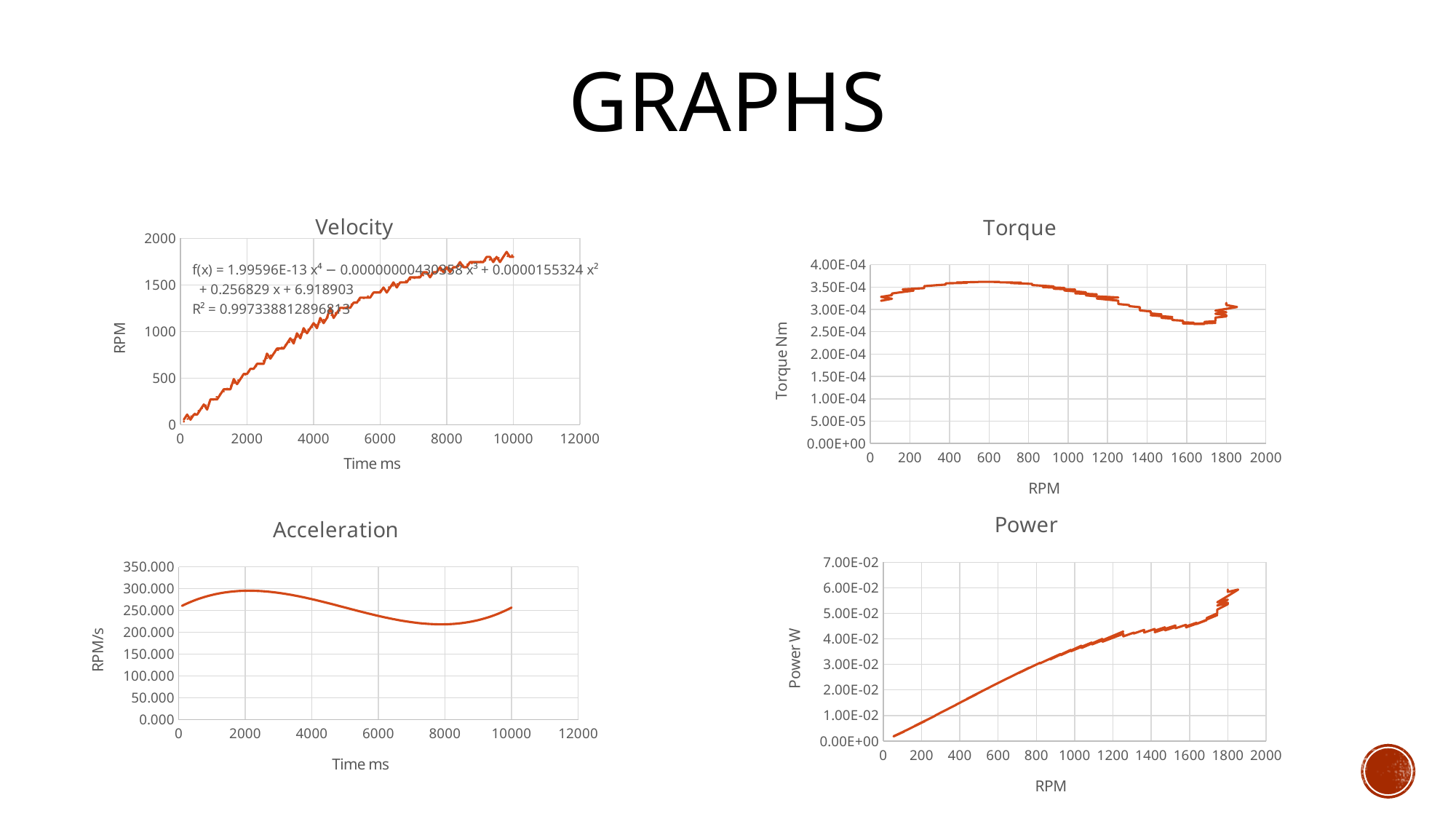
In the Power chart, does the power rise or fall as RPM increases? rise In the Acceleration chart, is the value at 8000 ms greater or less than 250.000? less In the Acceleration chart, is the value at 2000 ms greater or less than 250.000? greater In the Power chart, is the power at 1000 RPM greater or less than 3.00E-02? greater What kind of chart is the Velocity chart? line chart What is the y-axis title of the Torque chart? Torque Nm In the Velocity chart, does the RPM value rise or fall as time increases? rise What R² value is printed on the Velocity chart? 0.997338812896813